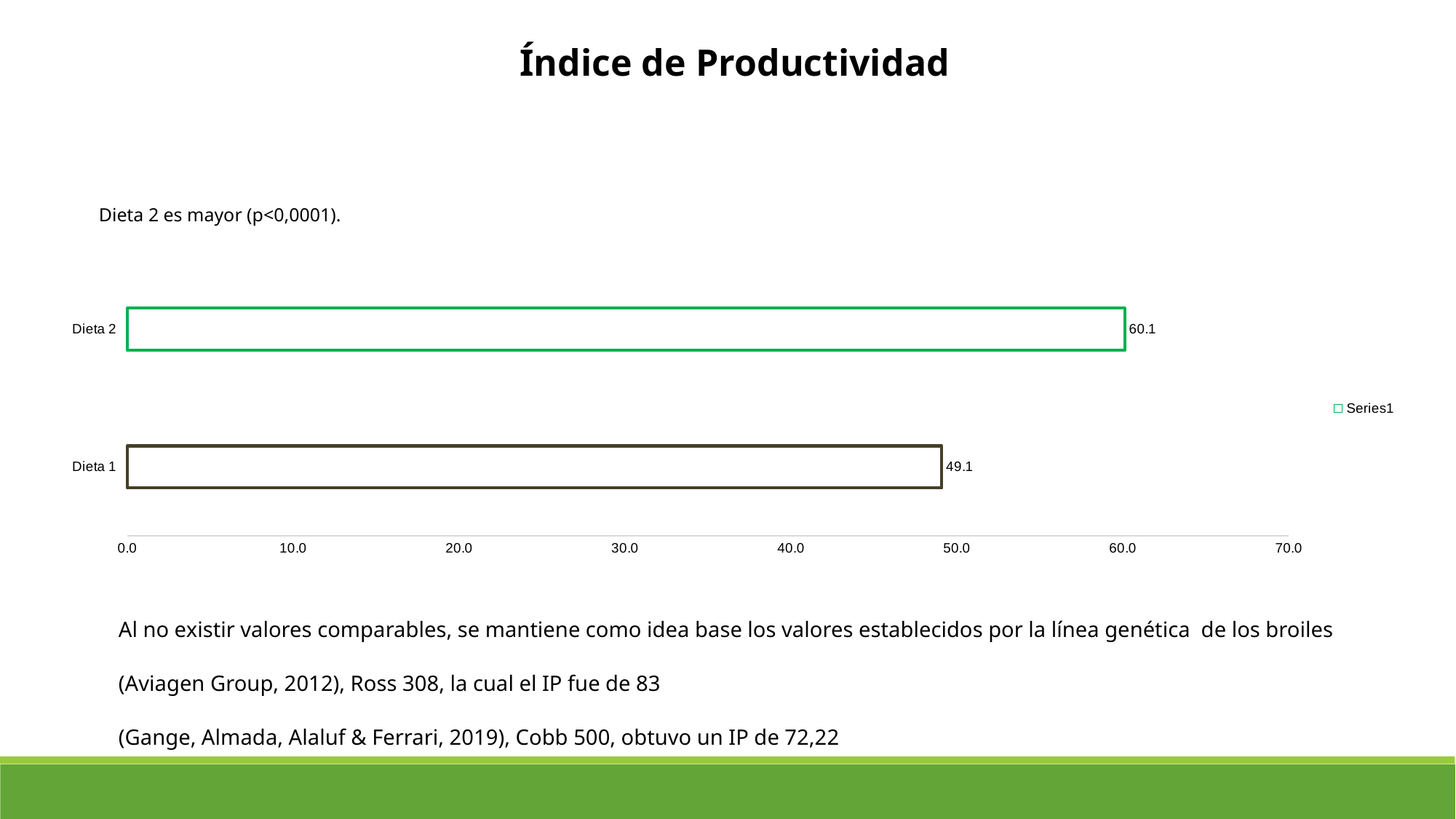
Which is larger, the value for Dieta 1 or the value for Dieta 2? Dieta 2 What is the difference between the values for Dieta 2 and Dieta 1? 11.0 What is the name of the series listed in the legend? Series1 Is the value for Dieta 2 greater or less than 60.0? greater Which category has the lowest value? Dieta 1 How many categories are shown in the chart? 2 What is the value for Dieta 1? 49.1 Which category has the highest value? Dieta 2 Is the value for Dieta 1 greater or less than 50.0? less What kind of chart is shown on the slide? bar chart How many series does the legend list? 1 What is the value for Dieta 2? 60.1